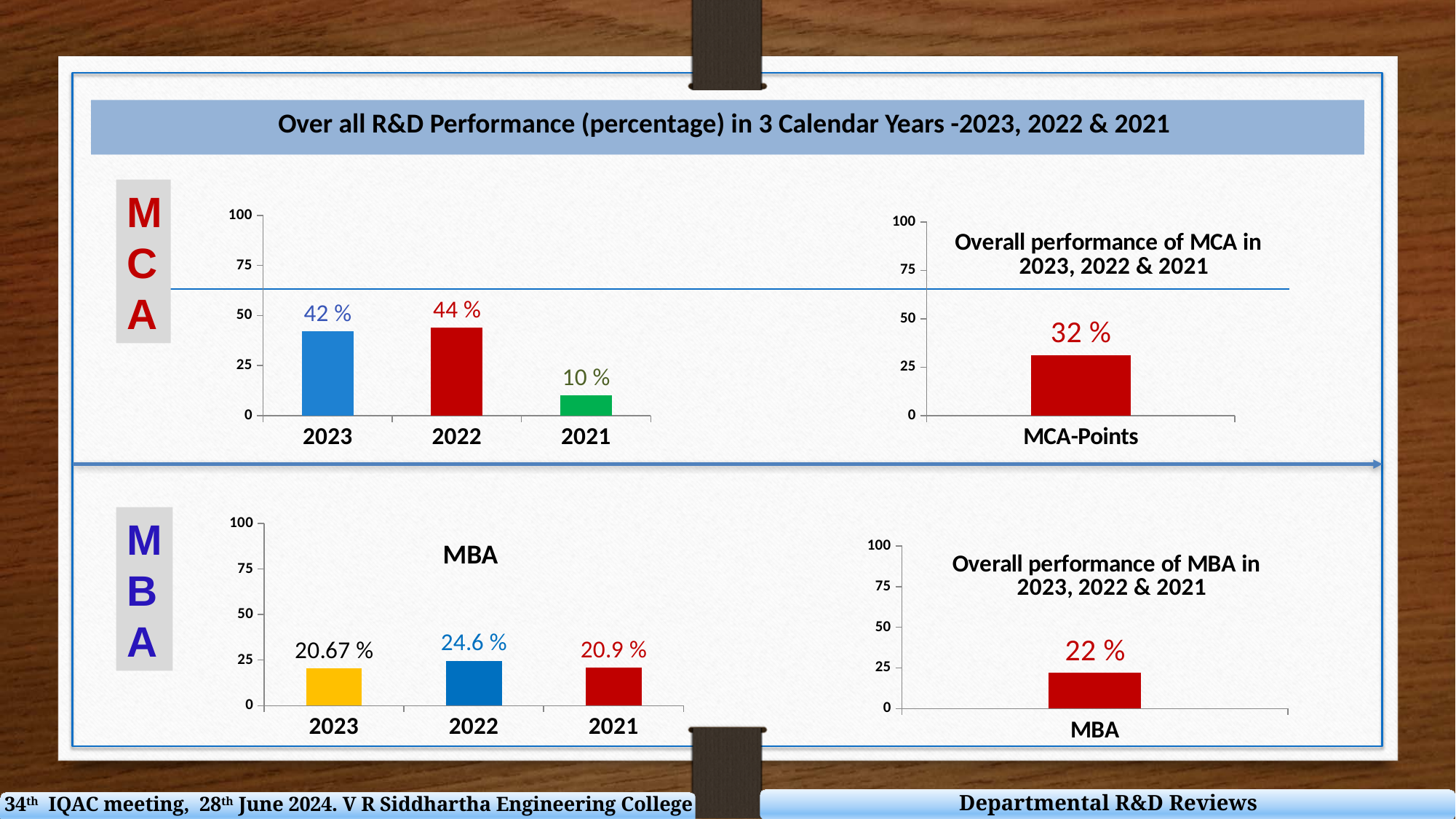
In the top-left MCA chart, what is the value for 2023? 42 % What kind of chart is the top-left MCA chart? Bar chart In the bottom-left MBA chart, what is the value for 2023? 20.67 % In the bottom-left MBA chart, how many years are plotted? 3 In the top-left MCA chart, which year has the highest value? 2022 In the top-left MCA chart, what is the difference between the 2022 and 2021 values? 34 % In the bottom-right chart titled 'Overall performance of MBA in 2023, 2022 & 2021', what is the value for MBA? 22 % Which is larger: the overall MCA-Points value in the top-right chart or the overall MBA value in the bottom-right chart? MCA-Points In the top-left MCA chart, which year has the lowest value? 2021 In the bottom-left MBA chart, what is the value for 2022? 24.6 % In the top-right chart titled 'Overall performance of MCA in 2023, 2022 & 2021', what is the value for MCA-Points? 32 % In the bottom-left MBA chart, which year has the highest value? 2022